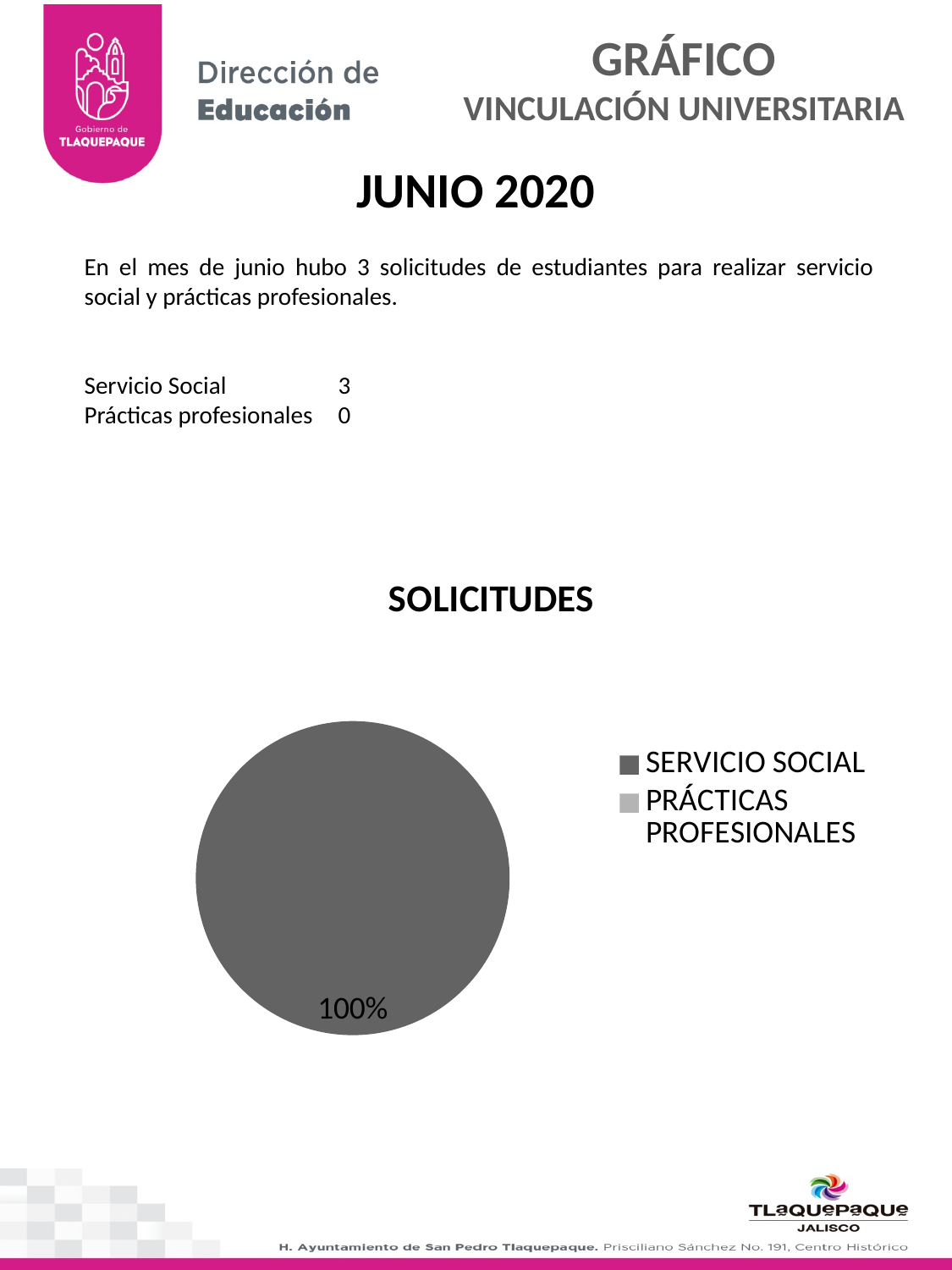
Which is larger in the pie chart, SERVICIO SOCIAL or PRÁCTICAS PROFESIONALES? SERVICIO SOCIAL What is the title of the chart? SOLICITUDES Which legend entry has no visible slice in the pie? PRÁCTICAS PROFESIONALES What colour is the SERVICIO SOCIAL slice in the pie chart? dark grey How many entries does the chart legend list? 2 What percentage label is shown on the pie slice? 100% Which category accounts for the whole pie? SERVICIO SOCIAL How many visible slices does the pie chart have? 1 What kind of chart is shown under the title SOLICITUDES? pie chart What share of the pie does SERVICIO SOCIAL represent? 100%